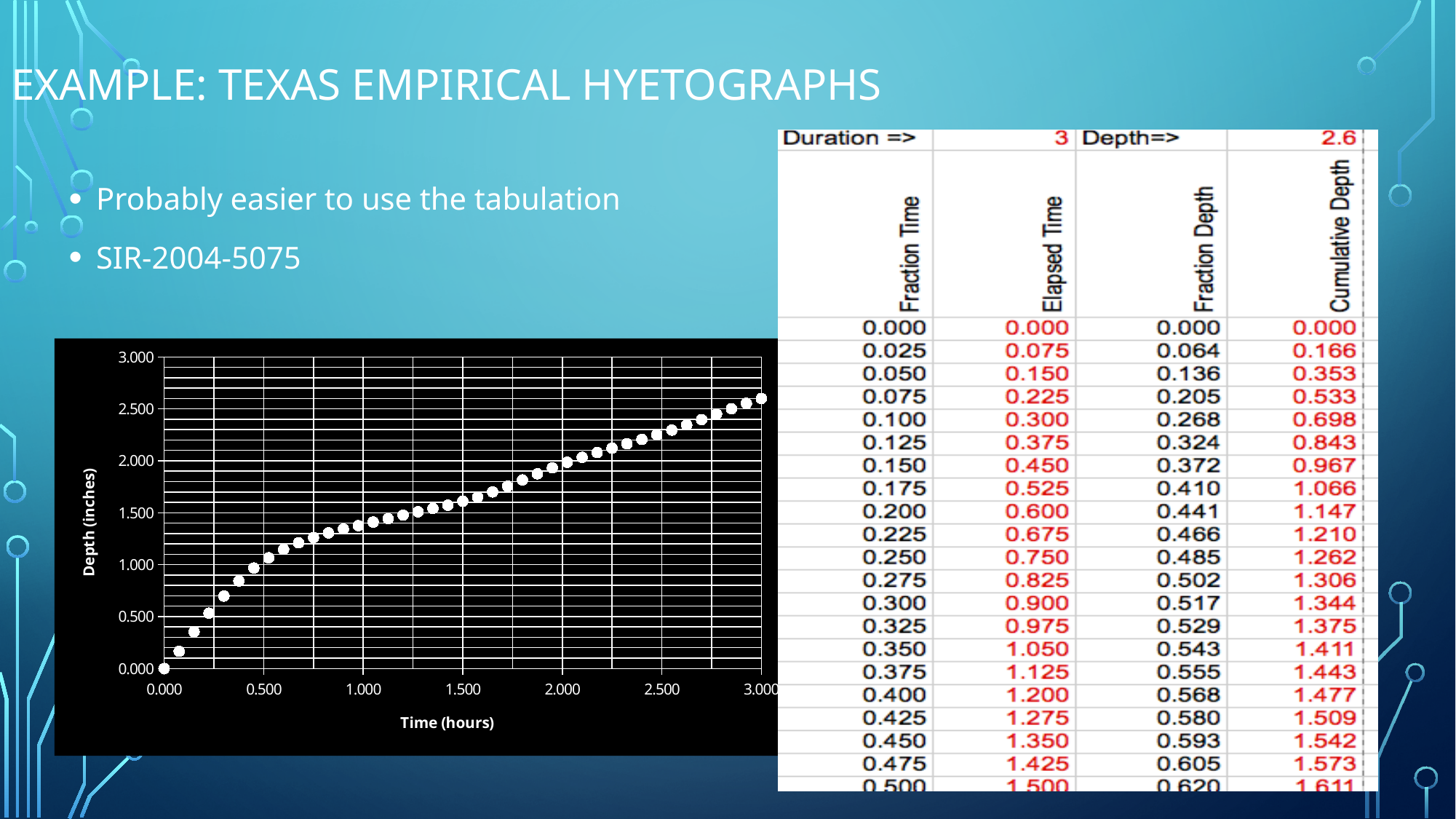
What is the label of the y axis of the chart? Depth (inches) Is the depth value at 1.000 hours greater or less than 1.000? greater Is the depth value at 1.000 hours greater or less than 1.500? less What kind of chart is shown on the slide? Scatter chart Is the depth value at 3.000 hours greater or less than 2.500? greater Which has the larger plotted depth: the point at 2.500 hours or the point at 1.000 hours? 2.500 hours What is the label of the x axis of the chart? Time (hours) At which time on the x axis is the plotted depth highest? 3.000 hours Do the plotted depth values rise or fall as time increases along the x axis? Rise What is the depth value plotted at time 0.000 hours? 0.000